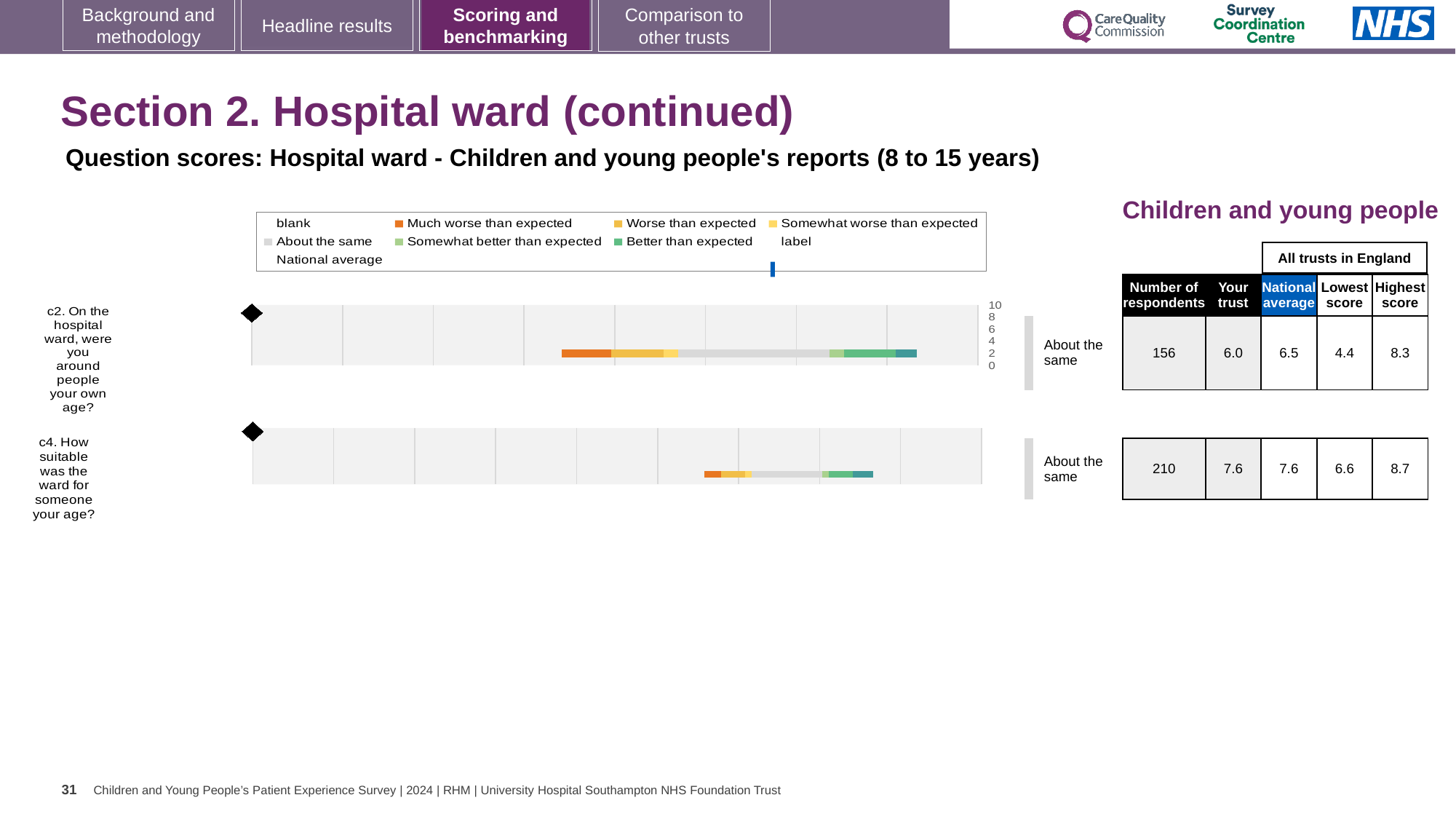
What is the lowest score among all trusts in England for question c2? 4.4 What is the difference between the national average and the 'Your trust' score for question c2? 0.5 What benchmark category is shown for question c4? About the same What is the title shown above the table on the right of the slide? Children and young people How many questions (categories) are plotted in the chart on this slide? 2 What kind of chart is used to show the question scores on this slide? bar chart What is the highest score among all trusts in England for question c4? 8.7 How many respondents answered question c4? 210 What is the national average score for question c2? 6.5 Which question has the higher 'Your trust' score, c2 or c4? c4 What is the 'Your trust' score for question c2 (On the hospital ward, were you around people your own age?)? 6.0 What is the 'Your trust' score for question c4 (How suitable was the ward for someone your age?)? 7.6